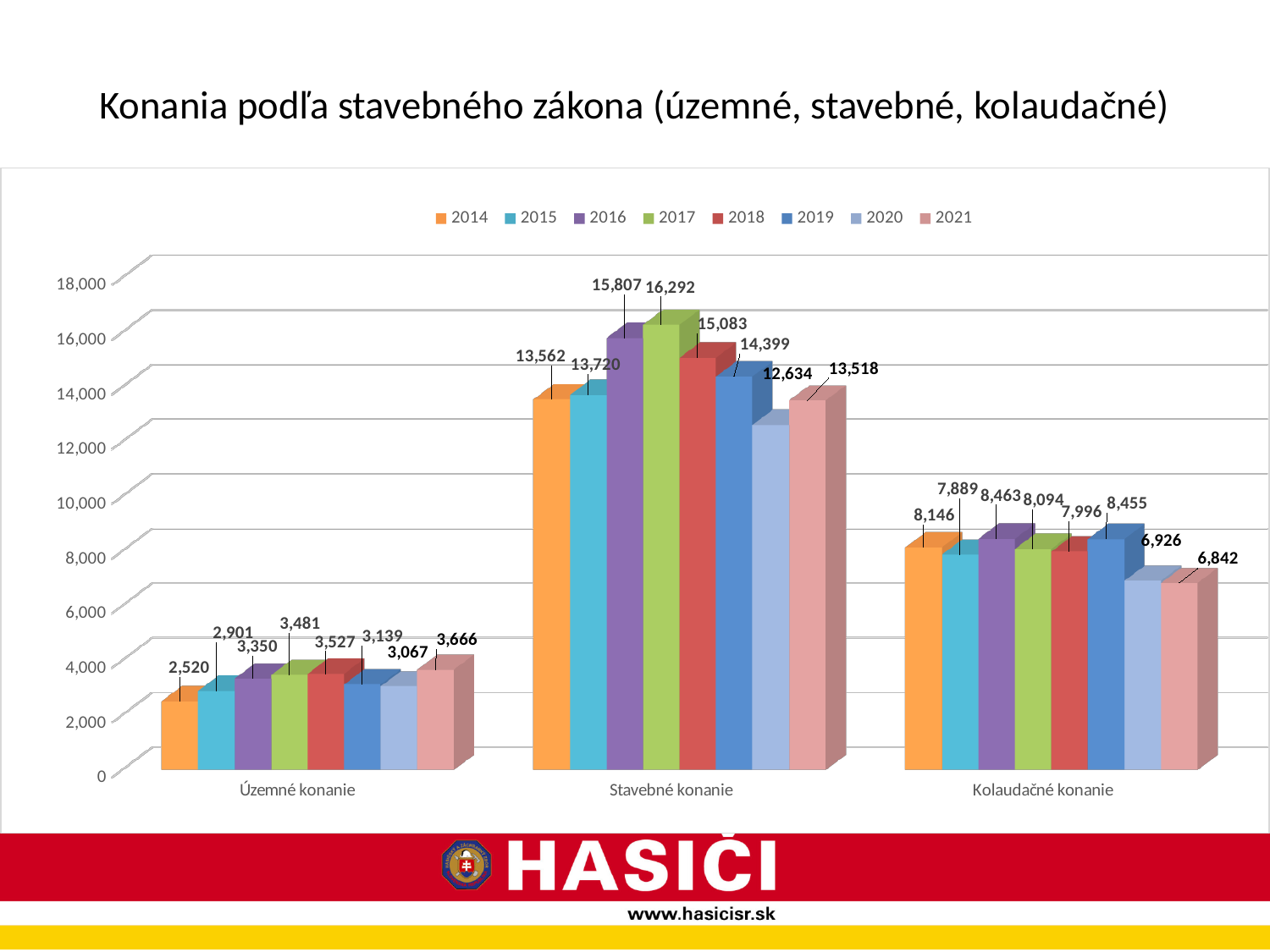
What is the title of the slide? Konania podľa stavebného zákona (územné, stavebné, kolaudačné) What is the difference between the 2017 and 2020 values in the Stavebné konanie category? 3,658 How many categories are shown on the x axis? 3 Which is larger in the Kolaudačné konanie category: the value for 2016 or the value for 2020? 2016 Which year has the lowest value in the Územné konanie category? 2014 Which year has the highest value in the Stavebné konanie category? 2017 Which year has the lowest value in the Kolaudačné konanie category? 2021 What is the value for 2014 in the Územné konanie category? 2,520 What is the value for 2017 in the Stavebné konanie category? 16,292 What is the value for 2020 in the Kolaudačné konanie category? 6,926 What kind of chart is shown on the slide? Bar chart How many series does the legend list? 8